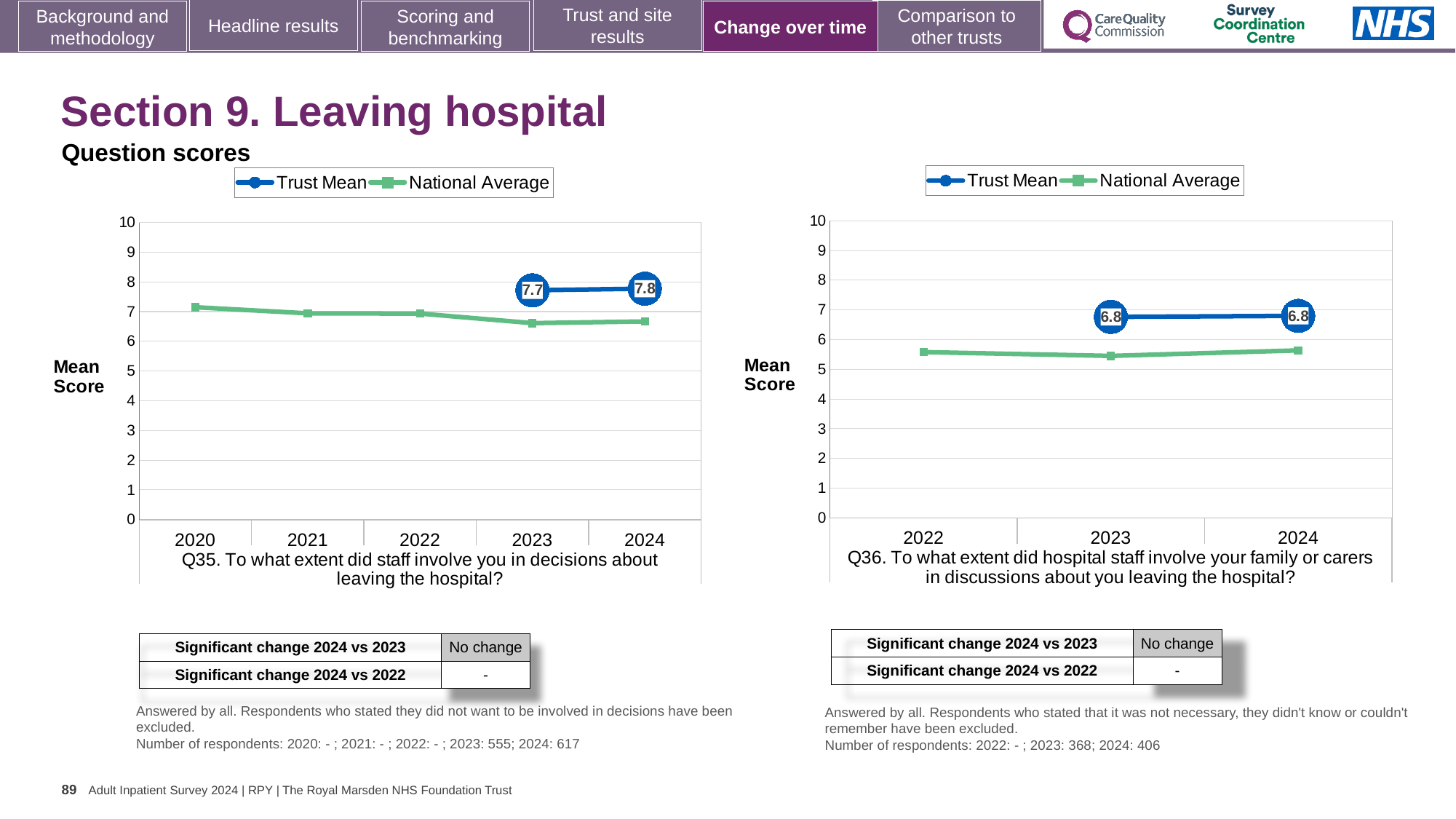
In the left chart (Q35), which year has the higher Trust Mean, 2023 or 2024? 2024 In the left chart (Q35), what is the Trust Mean value for 2023? 7.7 In the left chart (Q35), what is the difference between the Trust Mean values for 2024 and 2023? 0.1 In the left chart (Q35), what is the Trust Mean value for 2024? 7.8 In the left chart (Q35), is the National Average value for 2023 greater or less than 7? less In the right chart (Q36), is the National Average value for 2022 greater or less than 5? greater In the right chart (Q36), what is the Trust Mean value for 2024? 6.8 In the right chart (Q36), is the Trust Mean for 2023 greater or less than the National Average for 2023? greater How many series does the legend of the right chart (Q36) list? 2 How many years are shown on the x axis of the left chart (Q35)? 5 How many years are shown on the x axis of the right chart (Q36)? 3 What kind of chart is the left chart (Q35)? Line chart